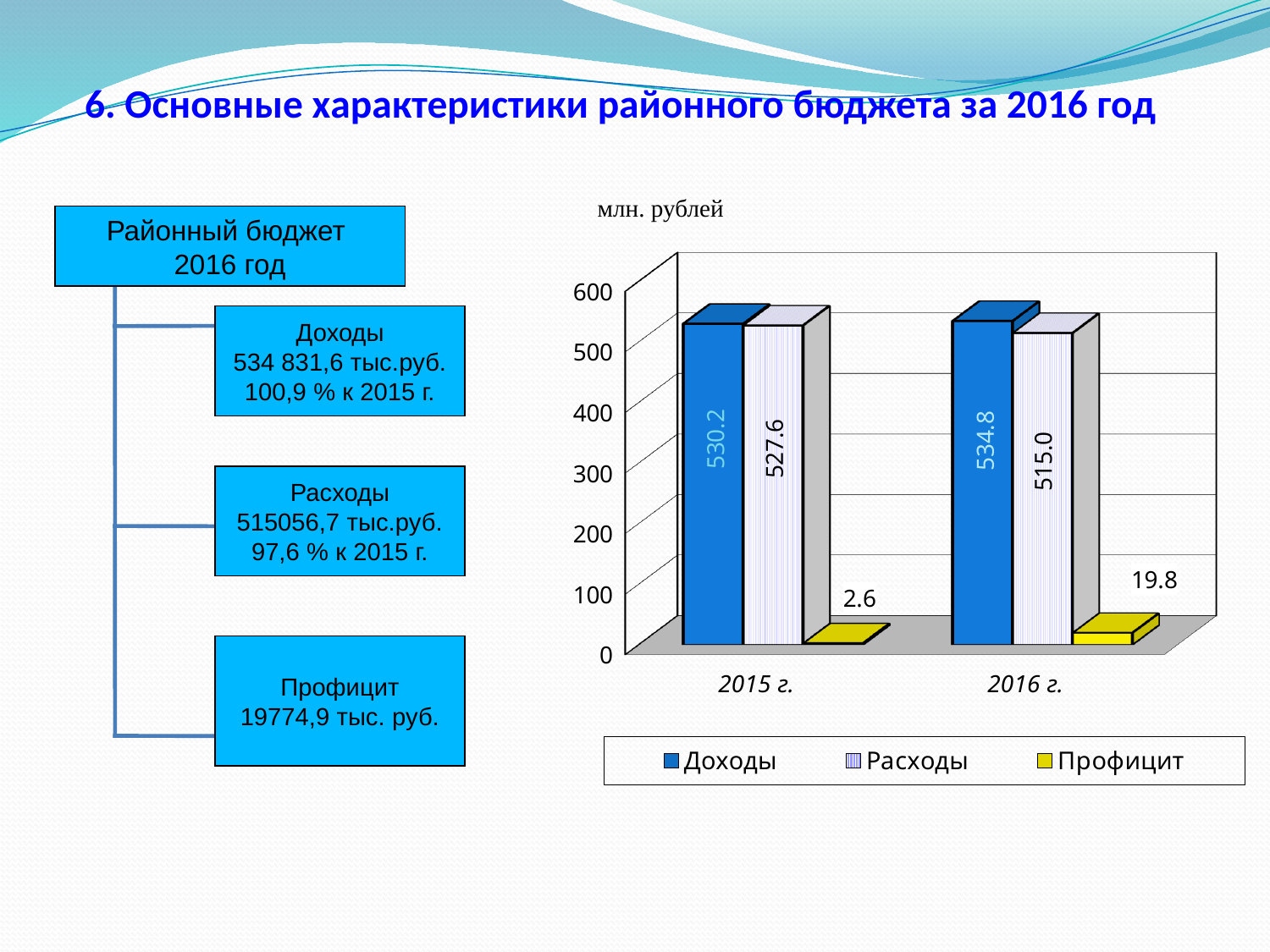
Which year has the higher value for Доходы? 2016 г. What unit is indicated above the chart? млн. рублей Is the value for Расходы in 2015 г. greater or less than 500? greater What is the value of Профицит for 2015 г.? 2.6 How many series does the legend list? 3 What is the value of Профицит for 2016 г.? 19.8 Which year has the lower value for Расходы? 2016 г. What is the difference between Доходы and Расходы in 2016 г.? 19.8 What is the value of Доходы for 2015 г.? 530.2 What kind of chart is shown on the slide? bar chart By how much did Профицит increase from 2015 г. to 2016 г.? 17.2 What is the value of Расходы for 2016 г.? 515.0